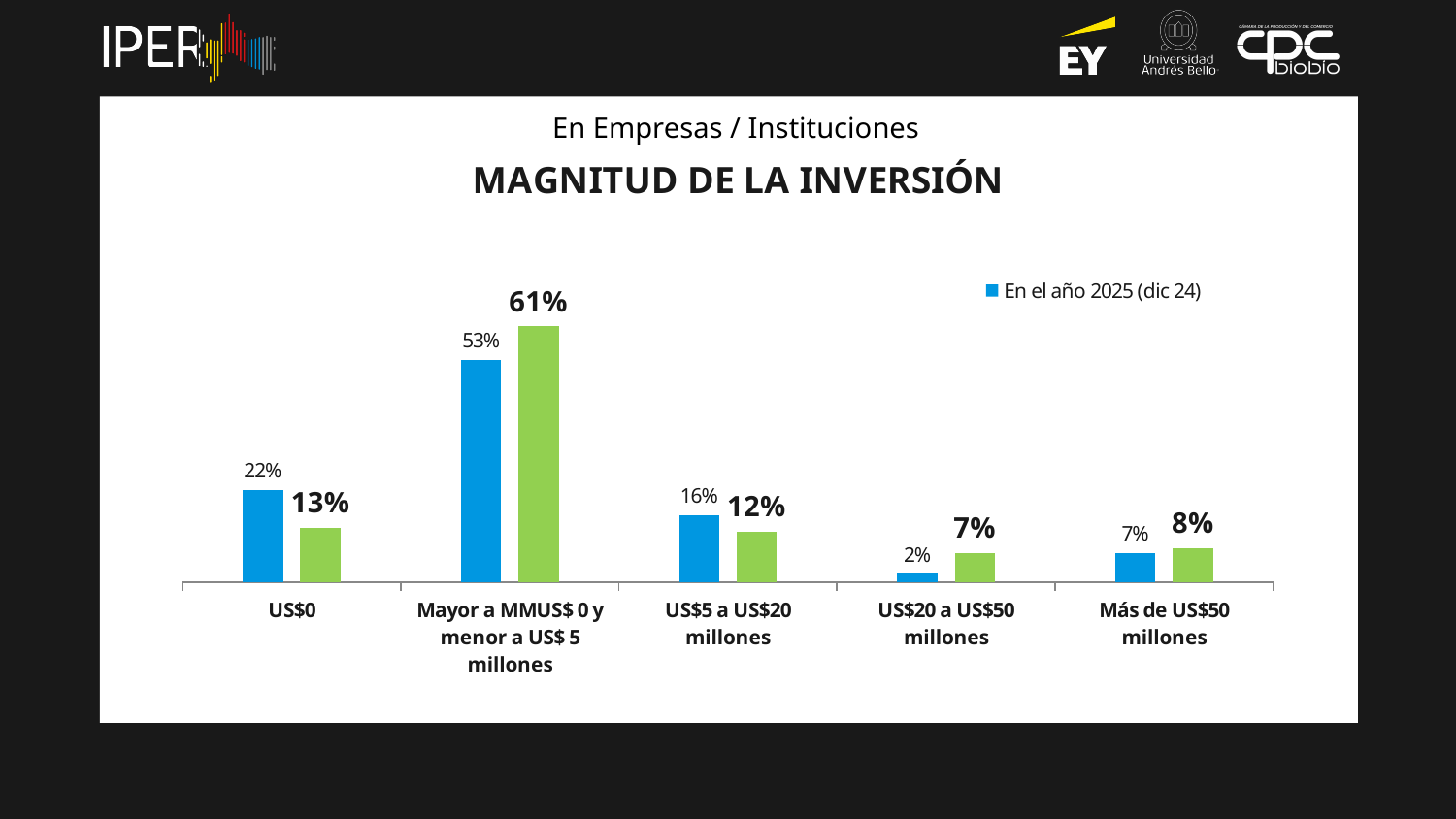
What is the value of the green bar for 'Mayor a MMUS$ 0 y menor a US$ 5 millones'? 61% Which category has the lowest value for the blue series (En el año 2025 (dic 24))? US$20 a US$50 millones What is the value of the blue bar (En el año 2025 (dic 24)) for US$0? 22% What is the difference between the green bar and the blue bar for 'Mayor a MMUS$ 0 y menor a US$ 5 millones'? 8% How many categories are shown on the x axis? 5 Which category has the highest value for the blue series (En el año 2025 (dic 24))? Mayor a MMUS$ 0 y menor a US$ 5 millones What is the title of the chart? MAGNITUD DE LA INVERSIÓN What is the value of the blue bar (En el año 2025 (dic 24)) for US$20 a US$50 millones? 2% What is the value of the green bar for US$0? 13% How many series does the legend list? 1 What kind of chart is shown on the slide? bar chart For US$5 a US$20 millones, which is larger: the blue bar or the green bar? the blue bar